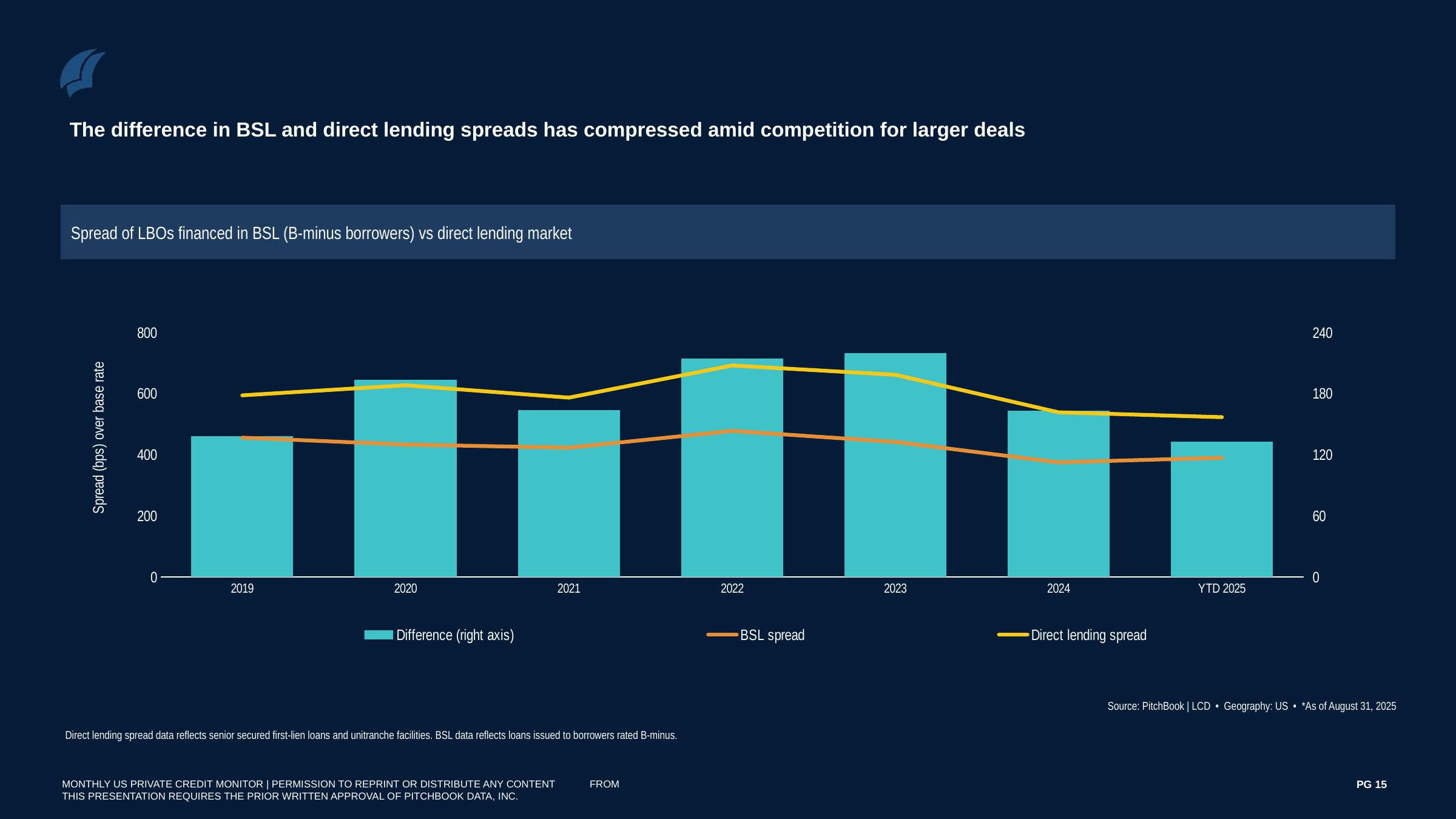
How many categories are shown on the x axis? 7 Does the Direct lending spread rise or fall from 2023 to YTD 2025? fall Is the Difference bar for 2023 greater or less than 180 on the right axis? greater In which year does the Direct lending spread line reach its highest point? 2022 What is the label of the left vertical axis? Spread (bps) over base rate Which is larger in 2022, the Direct lending spread or the BSL spread? Direct lending spread How many series does the legend list? 3 In which year does the BSL spread line reach its highest point? 2022 Is the Direct lending spread value for 2022 greater or less than 600? greater Is the Direct lending spread value for YTD 2025 greater or less than 600? less Which series is plotted as bars? Difference (right axis) What kind of chart is shown on the slide? A combined bar and line chart